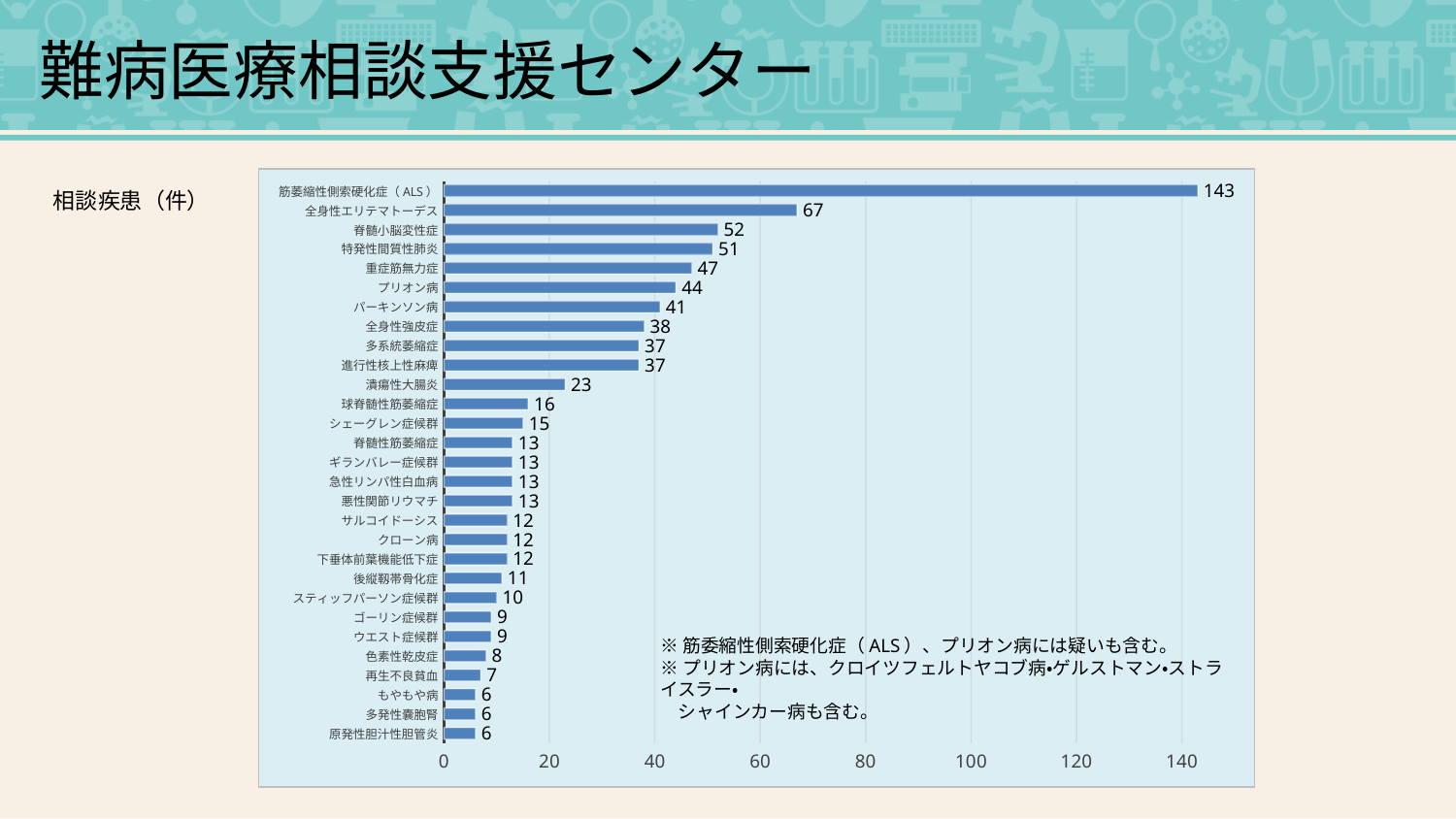
Which category has the highest value? 筋萎縮性側索硬化症（ALS） What is the difference between the values for 脊髄小脳変性症 and 特発性間質性肺炎? 1 Is the value for 重症筋無力症 greater or less than 40? greater What is the label shown to the left of the chart? 相談疾患（件） What is the value for プリオン病? 44 What is the difference between the values for 筋萎縮性側索硬化症（ALS） and 全身性エリテマトーデス? 76 What kind of chart is shown on the slide? bar chart What is the value for スティッフパーソン症候群? 10 Which is larger, the value for パーキンソン病 or the value for 全身性強皮症? パーキンソン病 How many categories are shown in the chart? 29 What is the value for 筋萎縮性側索硬化症（ALS）? 143 What is the value for 潰瘍性大腸炎? 23